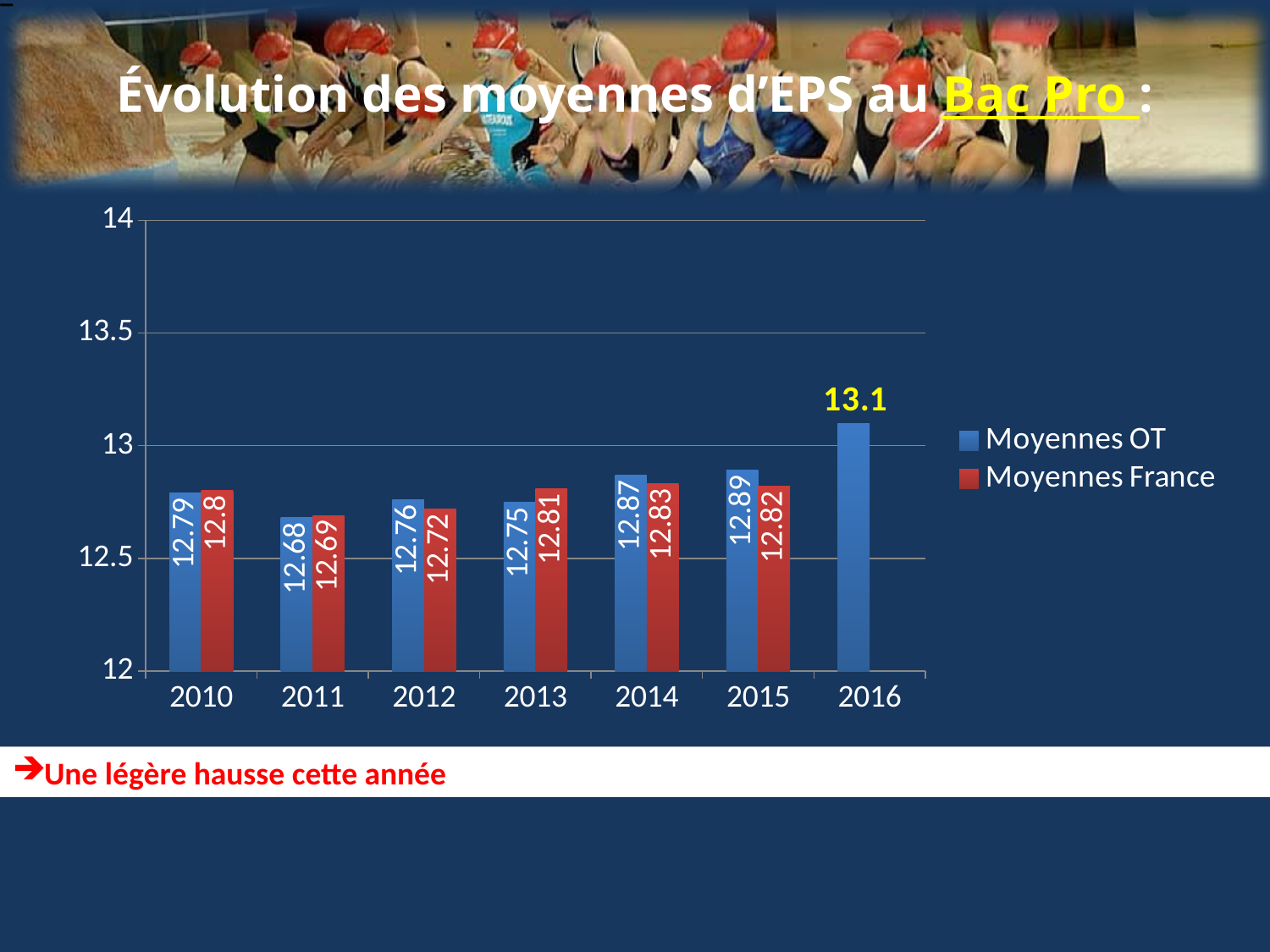
What is the value for Moyennes France in 2013? 12.81 What kind of chart is shown on the slide? bar chart In 2013, which is larger: Moyennes OT or Moyennes France? Moyennes France Which year has the highest value for Moyennes OT? 2016 How many series does the legend list? 2 How many years are shown on the x axis? 7 Which year has the lowest value for Moyennes France? 2011 Is the value for Moyennes OT in 2016 greater or less than 13? greater What is the difference between Moyennes OT in 2016 and Moyennes OT in 2015? 0.21 Which colour represents Moyennes France in the chart? red What is the value for Moyennes OT in 2016? 13.1 What is the value for Moyennes OT in 2011? 12.68